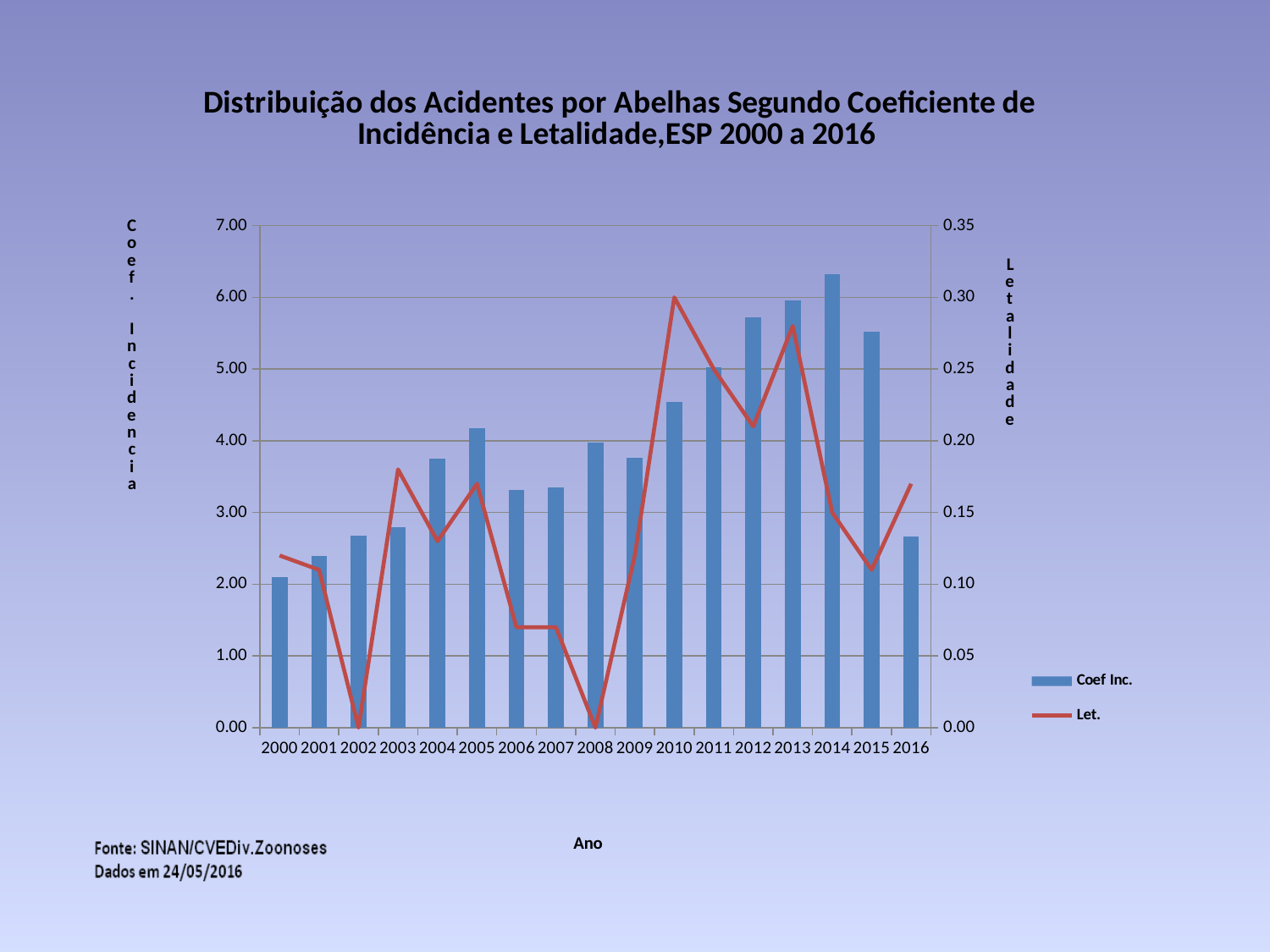
Is the Coef Inc. value for 2000 greater or less than 3.00? less Is the Coef Inc. value for 2014 greater or less than 6.00? greater Which year has a larger Coef Inc. value, 2012 or 2005? 2012 In which year is the Coef Inc. bar the highest? 2014 In which year is the Coef Inc. bar the lowest? 2000 How many series does the legend list? 2 In which year does the Let. line reach its highest point? 2010 What is the Let. value for 2002? 0.00 How many years are shown along the x axis? 17 What is the label of the x axis? Ano Is the Let. value for 2013 greater or less than 0.25? greater What kind of chart is shown on the slide? A bar chart combined with a line chart